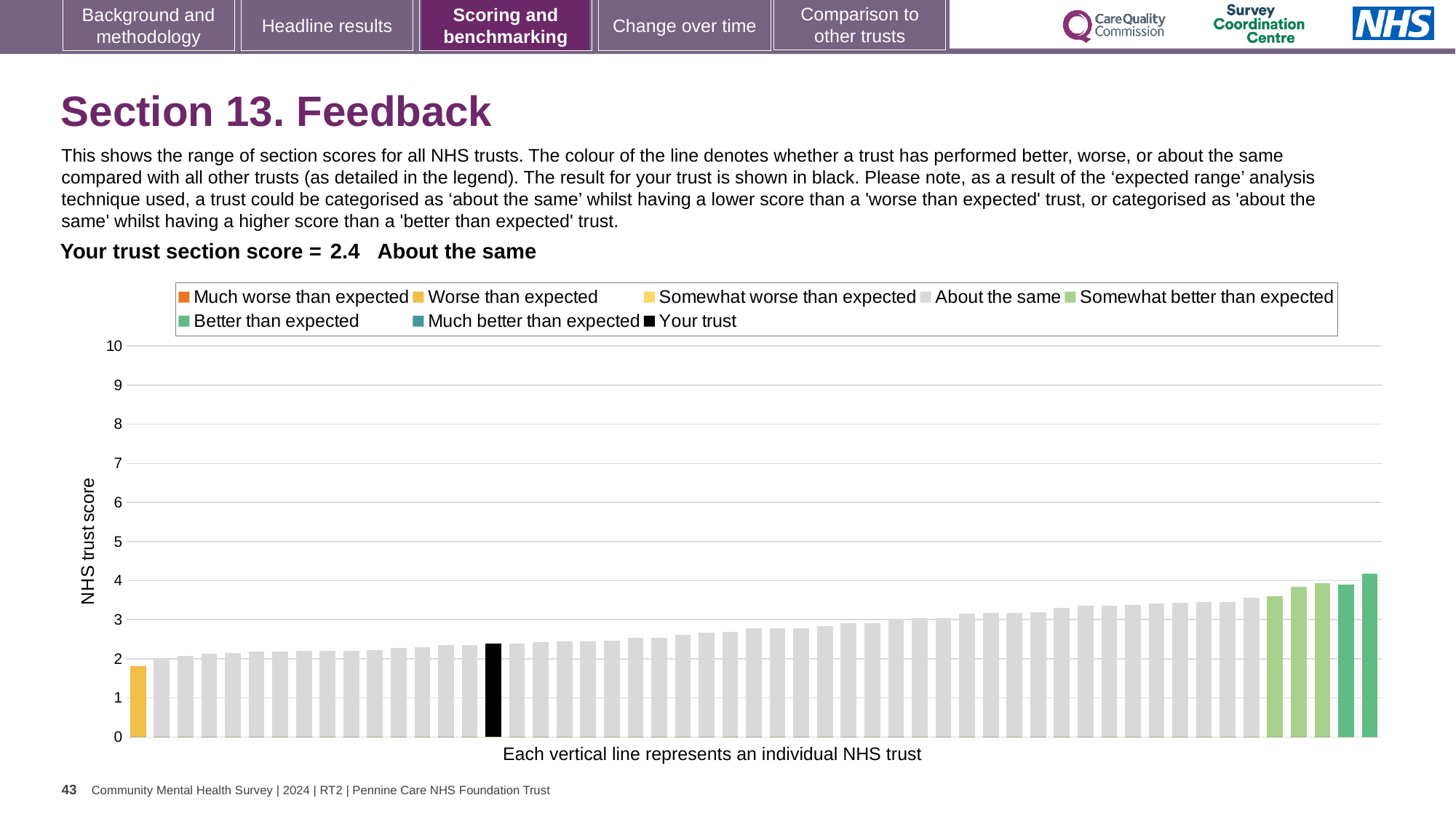
What is the highest value shown on the vertical axis? 10 Is the value for the lowest-scoring trust greater or less than 2? less What is the label on the vertical axis of the chart? NHS trust score Is the value for the highest-scoring trust greater or less than 5? less Which category is your trust placed in according to the slide? About the same How many entries does the chart legend list? 8 Is the value for your trust greater or less than 3? less Do the bar values rise or fall from left to right along the x axis? rise What is the section score for your trust shown on the slide? 2.4 What kind of chart is shown on the slide? Bar chart Which is larger: the value for your trust or the value for the leftmost (yellow) bar? Your trust What colour is the bar representing your trust? Black